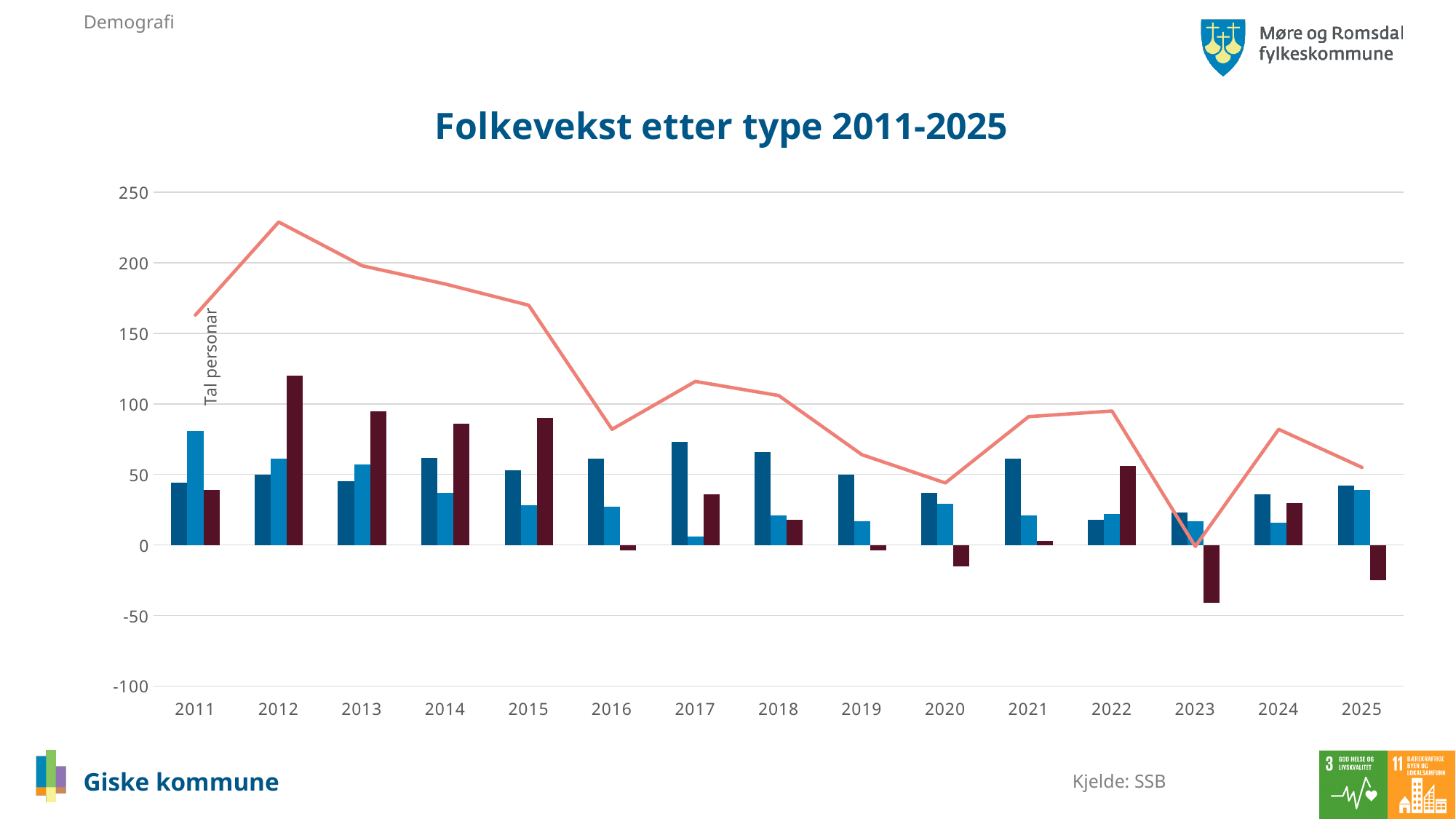
Does the salmon-coloured line rise or fall from 2012 to 2016? fall Which is larger, the value of the salmon-coloured line in 2013 or in 2015? 2013 In which year does the salmon-coloured line reach its highest value? 2012 Is the value of the dark red bar in 2023 greater or less than 0? less What is the title of the chart? Folkevekst etter type 2011-2025 What is the label on the vertical axis of the chart? Tal personar Is the value of the light blue bar in 2011 greater or less than 50? greater In which year is the dark red bar at its highest value? 2012 Is the value of the salmon-coloured line in 2012 greater or less than 200? greater What kind of chart is shown on the slide? Combined bar and line chart How many years are shown on the x axis of the chart? 15 In which year is the dark red bar at its lowest value? 2023